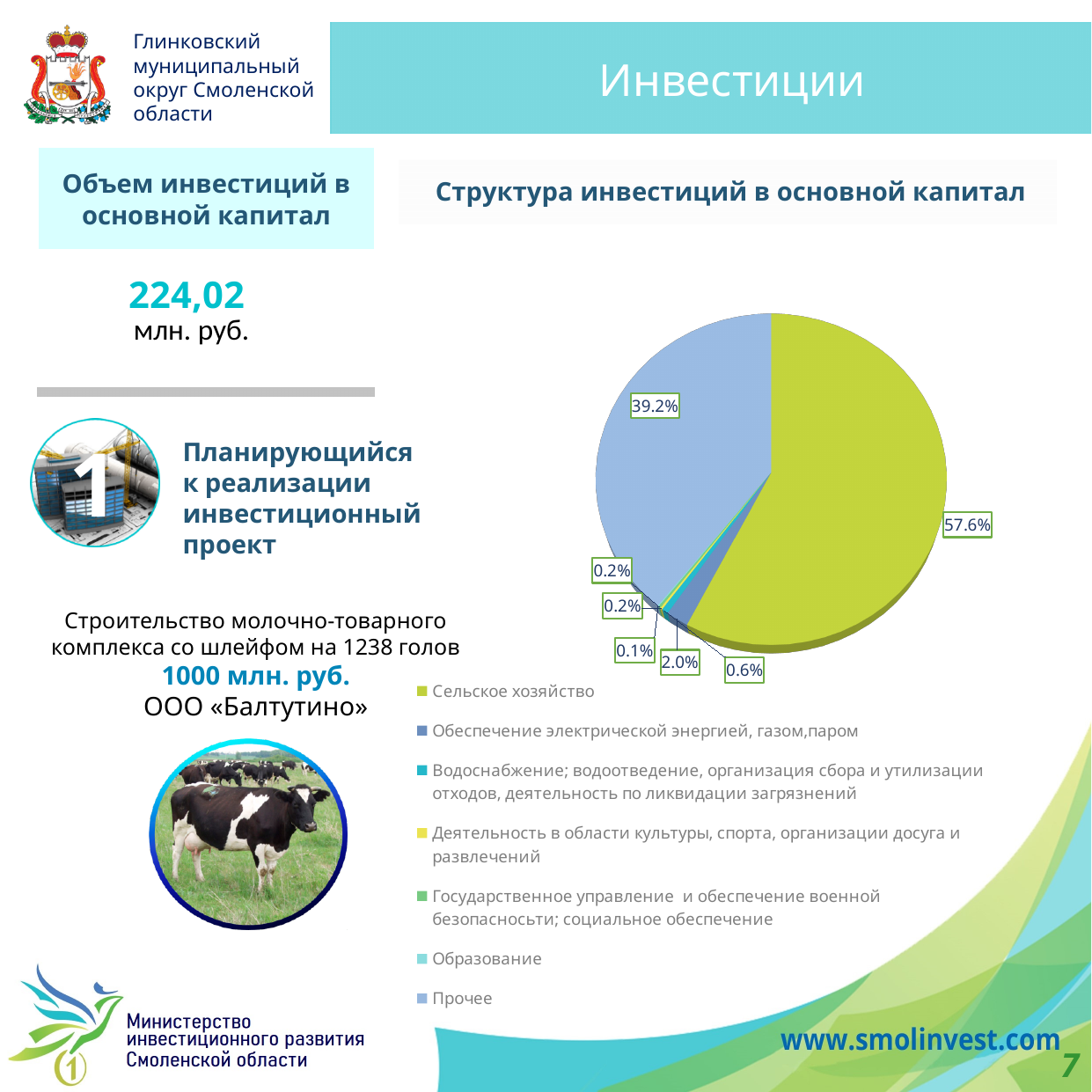
What is the smallest percentage labelled on the pie chart? 0.1% By how many percentage points does the «Сельское хозяйство» slice exceed the «Прочее» slice? 18.4 percentage points Which slice is larger: «Сельское хозяйство» or «Прочее»? Сельское хозяйство What kind of chart is shown under the heading «Структура инвестиций в основной капитал»? Pie chart How many categories does the legend of the pie chart list? 7 What share of the pie chart does «Прочее» account for? 39.2% Is the share for «Сельское хозяйство» greater or less than 50%? greater What share of the pie chart does «Обеспечение электрической энергией, газом, паром» account for? 2.0% What share of the pie chart does «Сельское хозяйство» account for? 57.6% What is the title of the pie chart? Структура инвестиций в основной капитал What colour is the largest slice of the pie chart? Yellow-green Which category has the largest slice in the pie chart? Сельское хозяйство